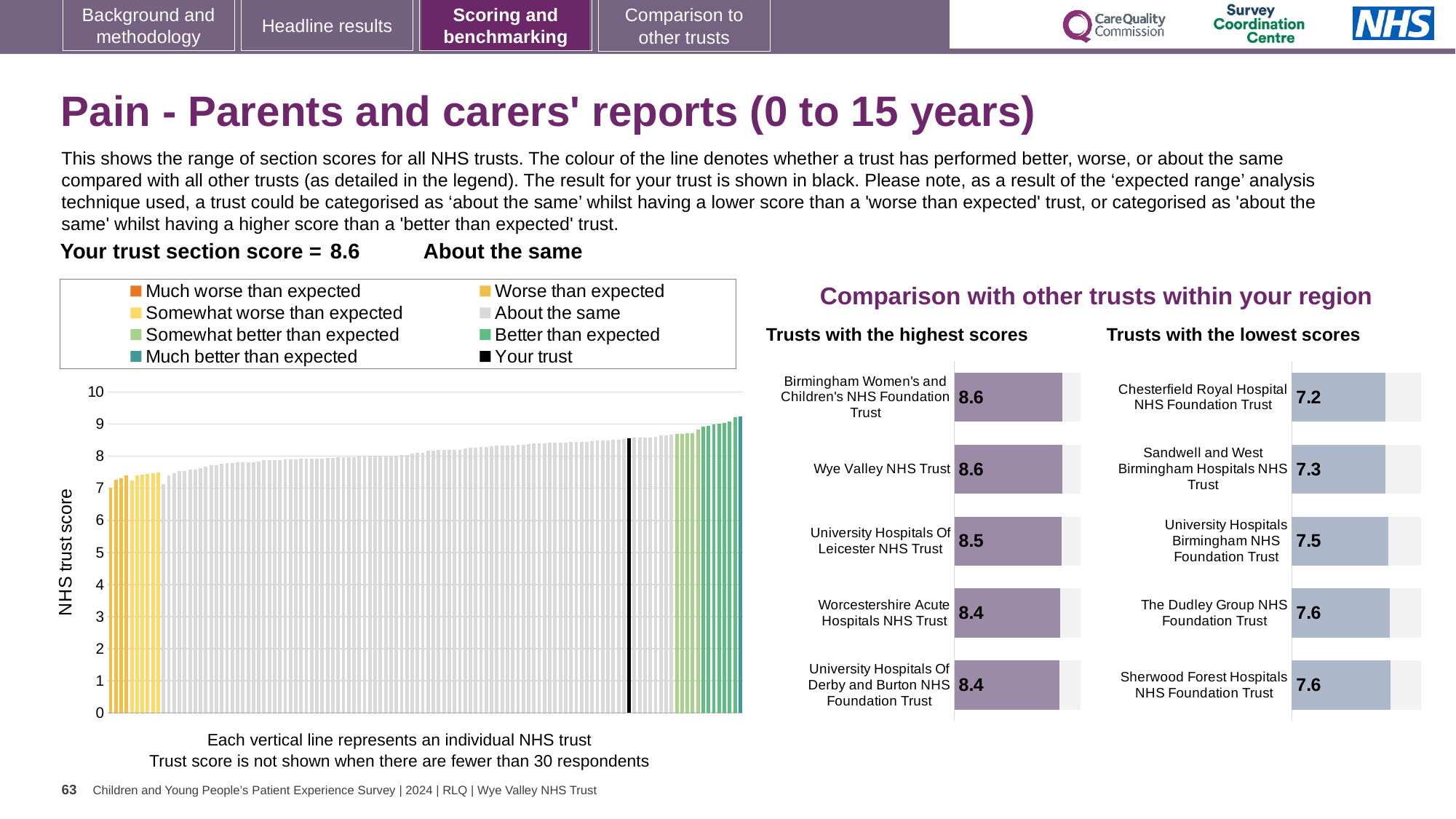
How many entries does the legend of the large chart on the left list? 8 In the 'Trusts with the lowest scores' chart, what is the score for University Hospitals Birmingham NHS Foundation Trust? 7.5 In the 'Trusts with the highest scores' chart, what is the score for Wye Valley NHS Trust? 8.6 In the 'Trusts with the lowest scores' chart, what is the score for Chesterfield Royal Hospital NHS Foundation Trust? 7.2 Which has the higher score: University Hospitals Of Leicester NHS Trust in the 'highest scores' chart or The Dudley Group NHS Foundation Trust in the 'lowest scores' chart? University Hospitals Of Leicester NHS Trust In the large chart on the left, is the value for the black 'Your trust' bar greater or less than 8? greater How many trusts are shown in the 'Trusts with the highest scores' chart? 5 In the 'Trusts with the lowest scores' chart, which trust has the lowest score? Chesterfield Royal Hospital NHS Foundation Trust What kind of chart is the large chart on the left showing NHS trust scores? bar chart In the 'Trusts with the lowest scores' chart, what is the difference between the scores of Sherwood Forest Hospitals NHS Foundation Trust and Chesterfield Royal Hospital NHS Foundation Trust? 0.4 In the 'Trusts with the highest scores' chart, what is the score for University Hospitals Of Leicester NHS Trust? 8.5 In the 'Trusts with the highest scores' chart, what is the difference between the scores of Birmingham Women's and Children's NHS Foundation Trust and Worcestershire Acute Hospitals NHS Trust? 0.2